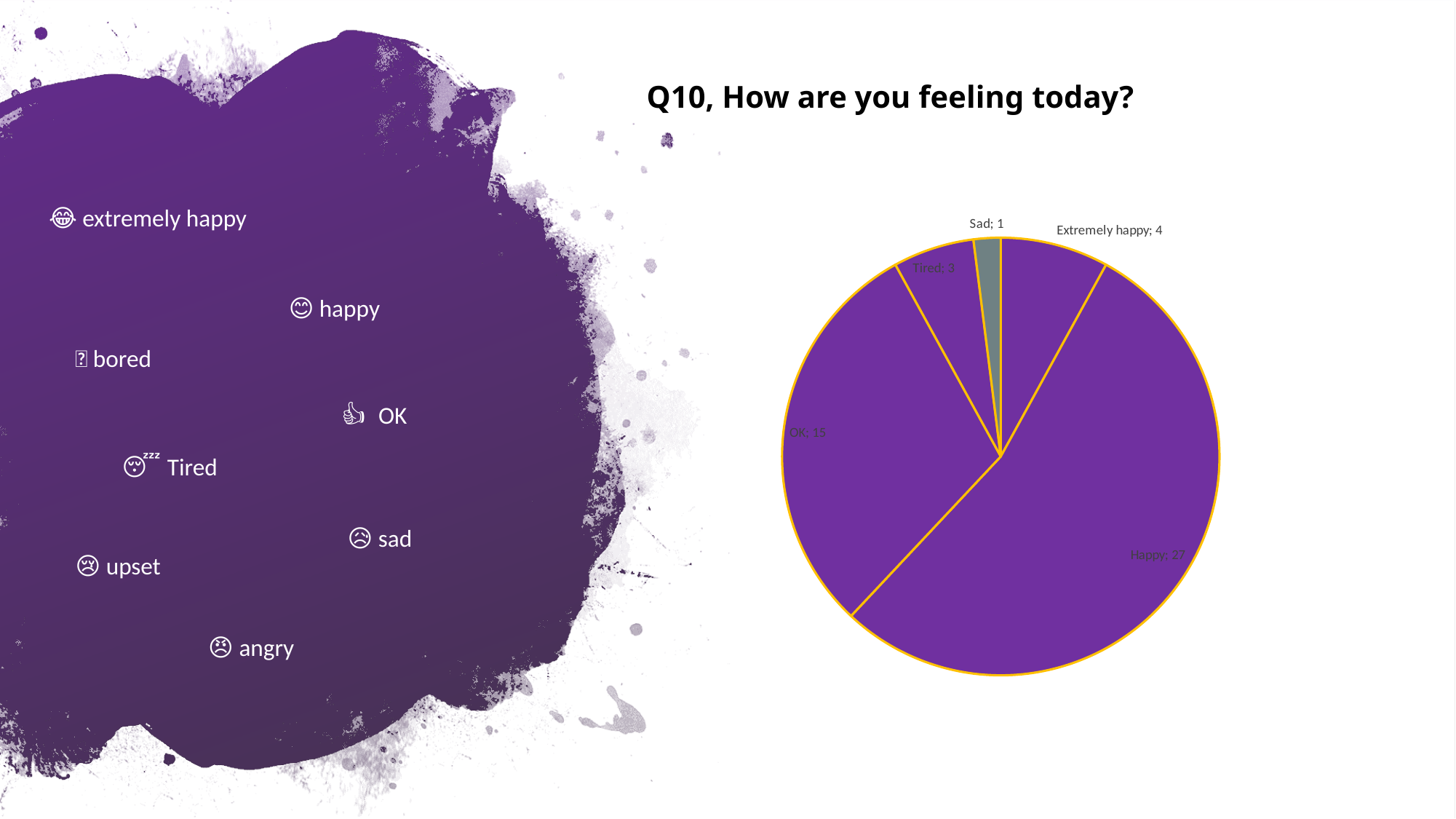
What is the total of all the slices in the pie chart? 50 Which is larger, Extremely happy or Tired? Extremely happy What is the value for Tired? 3 What kind of chart is shown on the slide? Pie chart What is the value for OK? 15 Which category has the smallest slice? Sad What share of the pie does Happy represent? 54% What is the value for Happy? 27 How many slices does the pie chart have? 5 Which category has the largest slice? Happy What is the title of the chart? Q10, How are you feeling today? What is the difference between the values for Happy and OK? 12